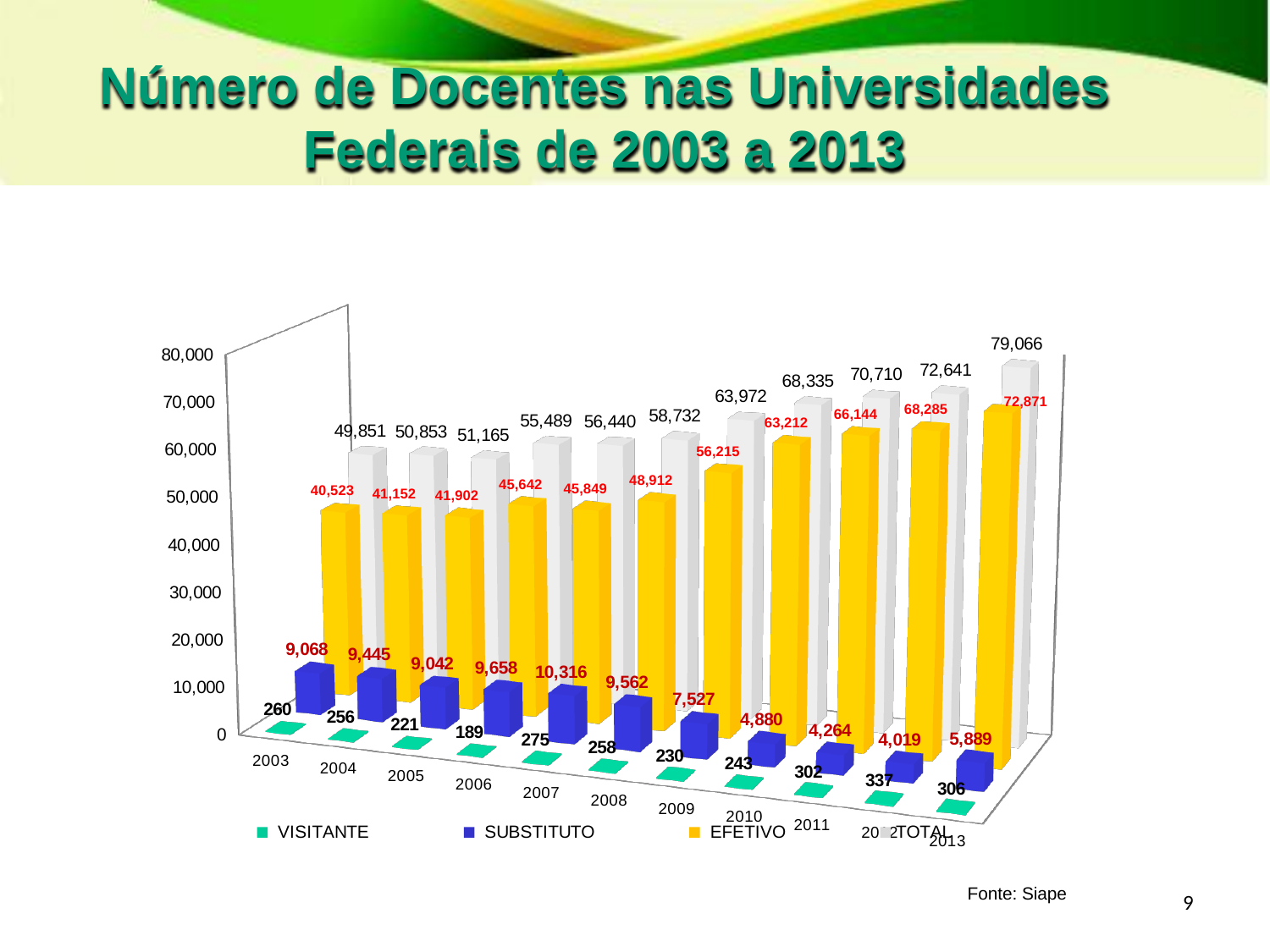
How many series does the legend list? 4 What is the TOTAL value for 2013? 79,066 What is the VISITANTE value for 2006? 189 In which year is the SUBSTITUTO value highest? 2007 In which year is the VISITANTE value lowest? 2006 What is the difference between the TOTAL values for 2013 and 2003? 29,215 What is the SUBSTITUTO value for 2007? 10,316 Which is larger, the SUBSTITUTO value for 2010 or for 2013? 2013 What kind of chart is shown on the slide? bar chart What is the EFETIVO value for 2009? 56,215 Is the EFETIVO value for 2011 greater or less than 60,000? greater How many years are shown on the x axis? 11